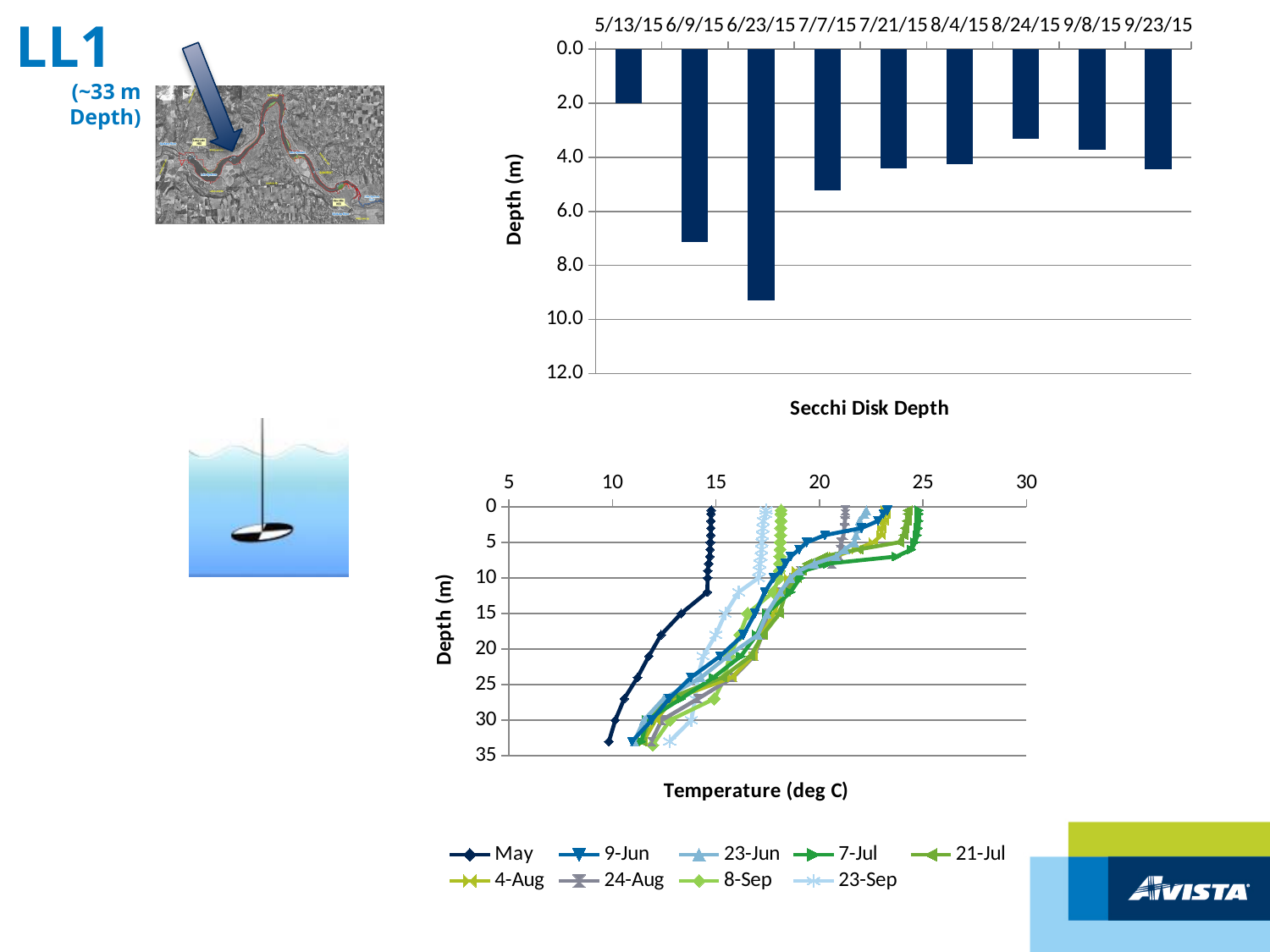
What kind of chart is the temperature profile chart at the bottom of the slide? line chart In the Secchi Disk Depth chart, is the depth for 6/9/15 greater or less than 6.0? greater In the Secchi Disk Depth chart, which date has the greatest Secchi depth? 6/23/15 In the temperature profile chart, which series has the lowest surface temperature at 0 m depth? May How many sampling dates are shown in the Secchi Disk Depth chart? 9 In the Secchi Disk Depth chart, which date has the smallest Secchi depth? 5/13/15 What kind of chart is the Secchi Disk Depth chart? bar chart In the Secchi Disk Depth chart, which date has the greater Secchi depth, 7/7/15 or 7/21/15? 7/7/15 How many series does the legend of the temperature profile chart list? 9 In the Secchi Disk Depth chart, is the depth for 8/24/15 greater or less than 4.0? less What is the x-axis title of the temperature profile chart? Temperature (deg C) In the Secchi Disk Depth chart, which date has the greater Secchi depth, 6/23/15 or 9/23/15? 6/23/15